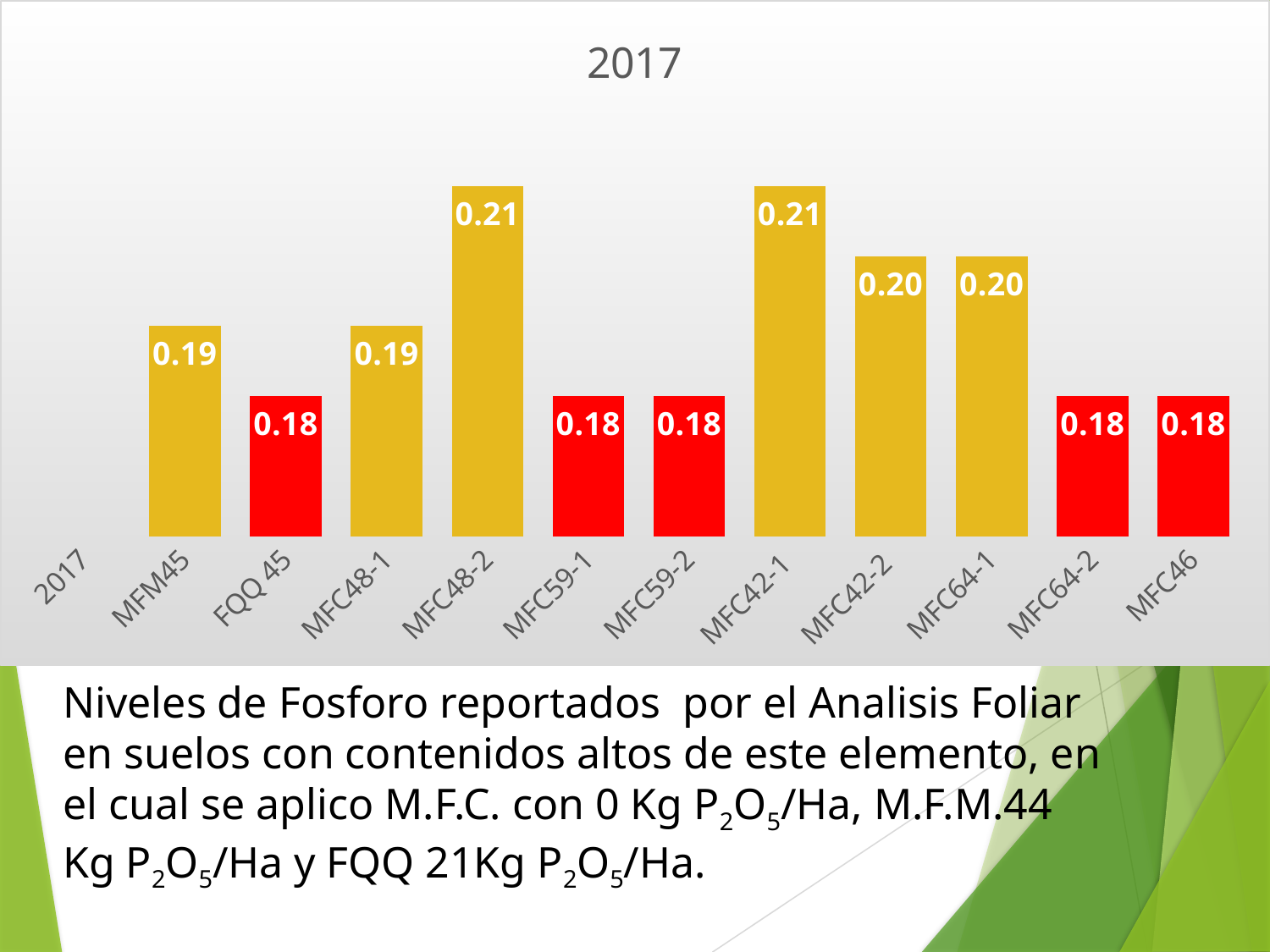
How many bars are plotted on the chart? 11 What is the difference between the values for MFC48-2 and FQQ 45? 0.03 What is the lowest value shown on the chart? 0.18 What is the highest value shown on the chart? 0.21 What is the value for FQQ 45? 0.18 Which has the larger value, MFC42-1 or MFC42-2? MFC42-1 What is the difference between the values for MFC42-2 and MFC64-2? 0.02 Which has the larger value, MFM45 or FQQ 45? MFM45 What is the value for MFM45? 0.19 What kind of chart is shown on the slide? Bar chart What is the value for MFC48-2? 0.21 What is the value for MFC64-1? 0.20